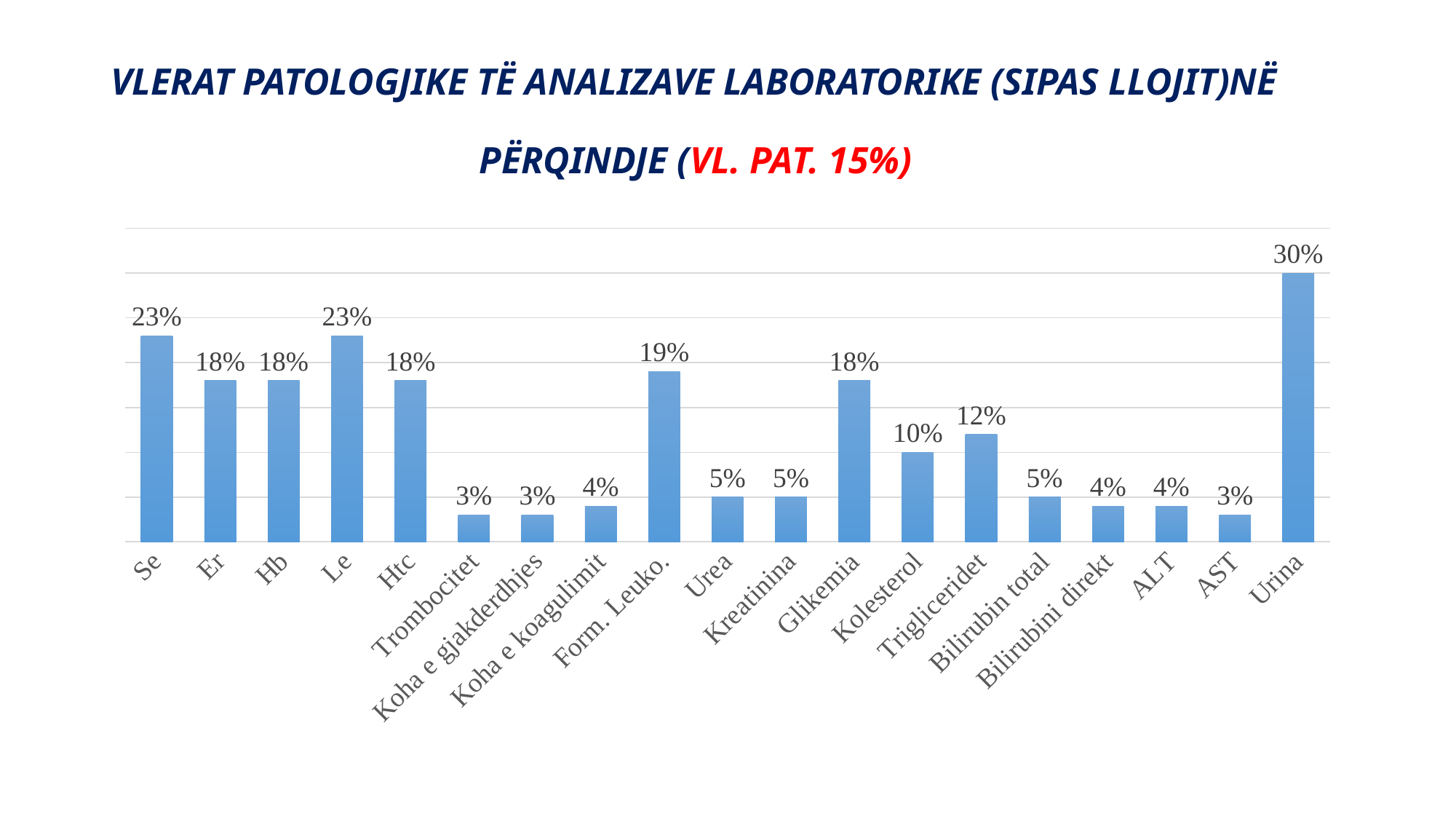
Which is larger, the value for Form. Leuko. or the value for Glikemia? Form. Leuko. Which category has the highest value? Urina What is the lowest value shown in the chart? 3% What is the value for Trombocitet? 3% What is the difference between the values for Trigliceridet and Kolesterol? 2 percentage points What kind of chart is shown on the slide? Bar chart What is the value for Urina? 30% What is the value for Kolesterol? 10% What is the difference between the values for Urina and Se? 7 percentage points What is the value for Form. Leuko.? 19% What is the value for Glikemia? 18% How many categories are shown in the chart? 19